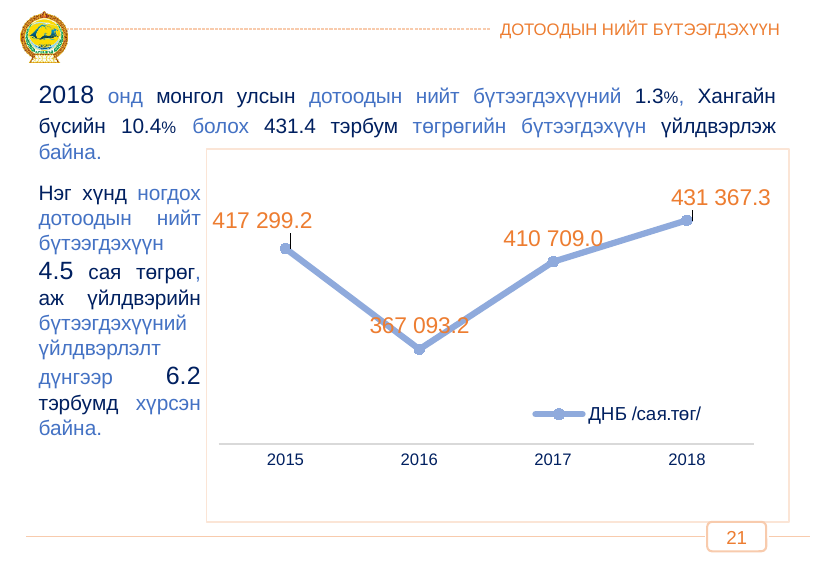
Which year has the highest value? 2018 What is the value for 2016? 367 093.2 Which year has the lowest value? 2016 What is the value for 2017? 410 709.0 What is the value for 2018? 431 367.3 What is the value for 2015? 417 299.2 What is the legend entry of the series shown on the chart? ДНБ /сая.төг/ Which is larger, the value for 2015 or the value for 2017? 2015 What kind of chart is shown on the slide? Line chart What is the difference between the values for 2018 and 2015? 14 068.1 How many years are plotted on the chart? 4 What is the difference between the values for 2017 and 2016? 43 615.8